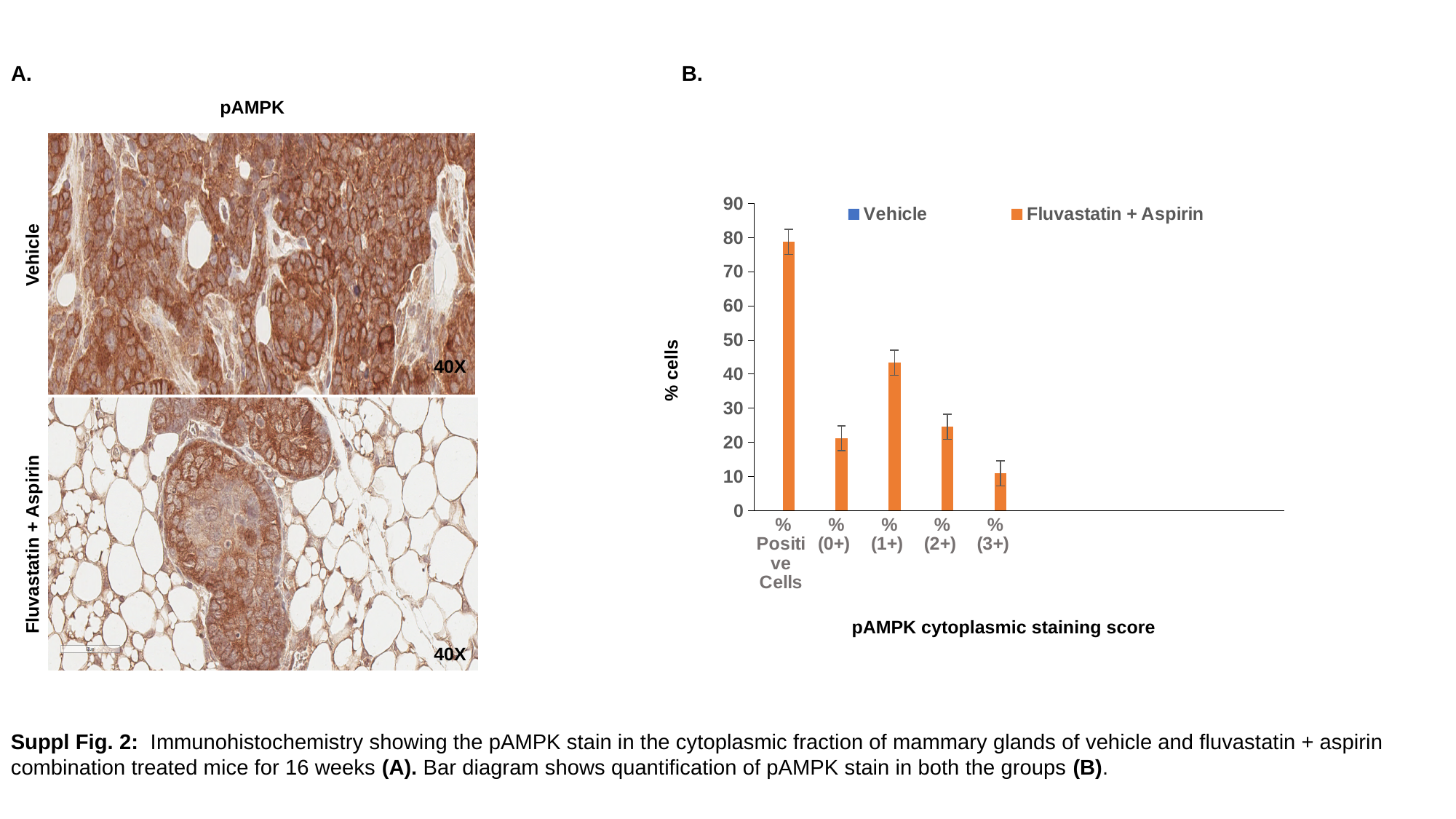
How many categories are shown on the x axis of the chart in panel B? 5 In the chart in panel B, which is larger for Fluvastatin + Aspirin: % (1+) or % (2+)? % (1+) How many series does the legend of the chart in panel B list? 2 In the chart in panel B, which category has the highest Fluvastatin + Aspirin bar? % Positive Cells What is the y-axis title of the chart in panel B? % cells In the chart in panel B, which is larger for Fluvastatin + Aspirin: % (0+) or % (3+)? % (0+) In the chart in panel B, is the Fluvastatin + Aspirin value for % (1+) greater or less than 40? greater What is the x-axis title of the chart in panel B? pAMPK cytoplasmic staining score In the chart in panel B, is the Fluvastatin + Aspirin value for % (3+) greater or less than 20? less What kind of chart is shown in panel B? bar chart In the chart in panel B, which category has the lowest Fluvastatin + Aspirin bar? % (3+) In the chart in panel B, is the Fluvastatin + Aspirin value for % Positive Cells greater or less than 70? greater